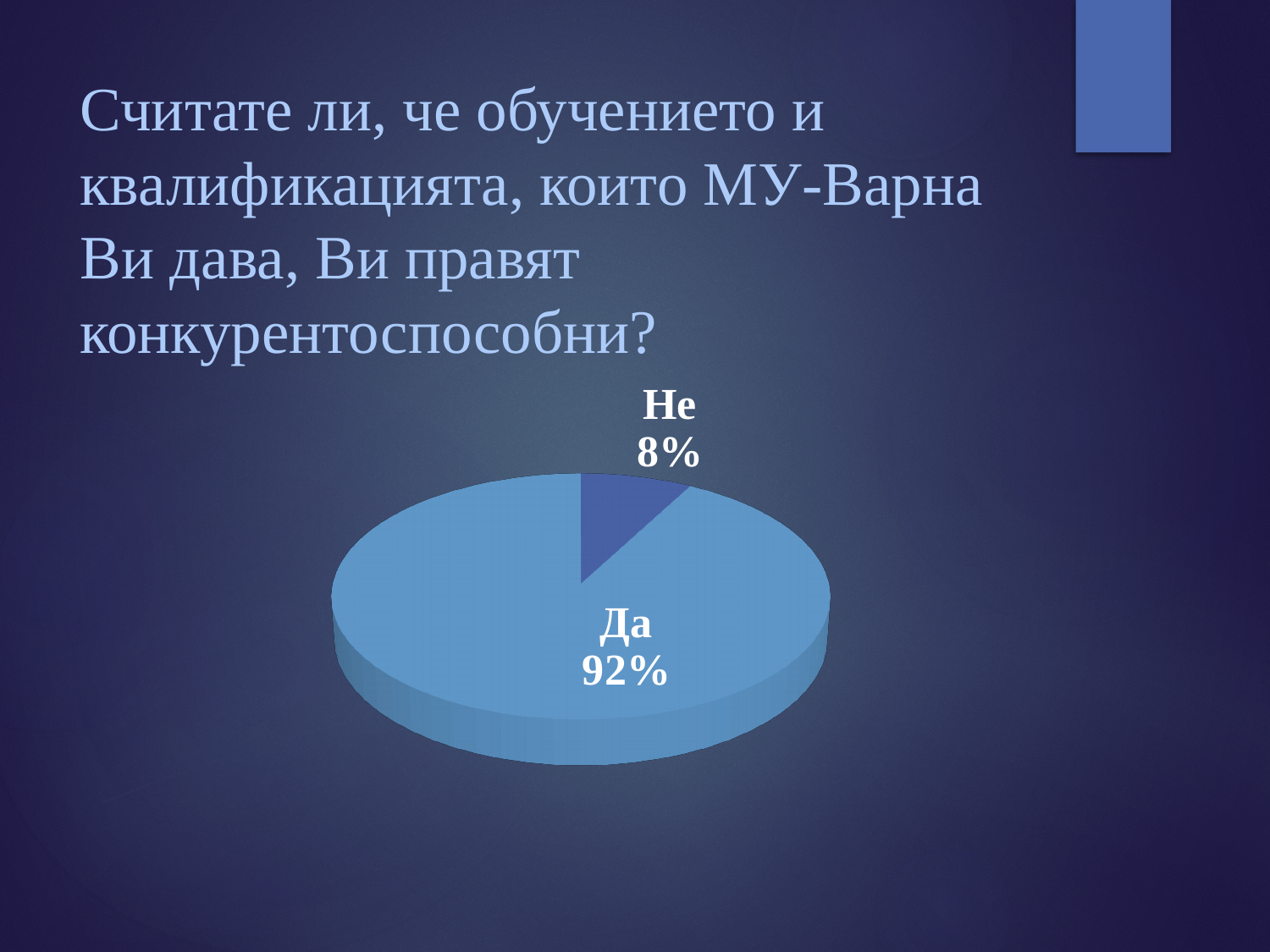
Which slice of the pie is the largest? Да What kind of chart is shown on the slide? pie chart What is the difference in percentage points between the "Да" and "Не" slices? 84 What colour is the "Не" slice of the pie? dark blue Which is larger, the "Да" slice or the "Не" slice? Да What question does the slide title ask about the chart data? Считате ли, че обучението и квалификацията, които МУ-Варна Ви дава, Ви правят конкурентоспособни? Which slice of the pie is the smallest? Не How many slices does the pie chart have? 2 What share of the pie does the "Не" slice represent? 8% What share of the pie does the "Да" slice represent? 92% What is the total of the two slice percentages shown on the pie? 100%